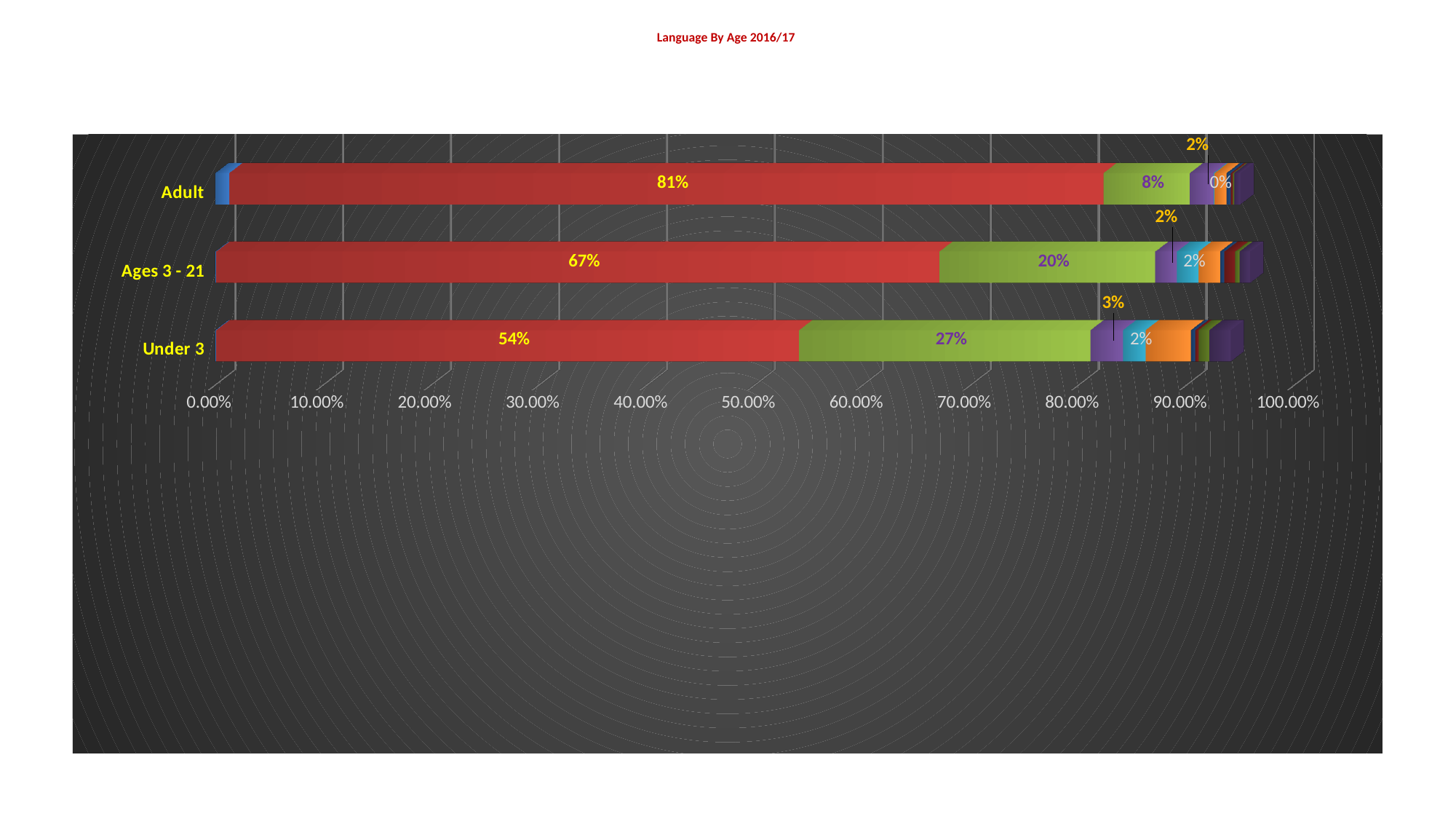
What is the value of the green segment for Adult? 8% What is the value of the red segment for Adult? 81% What is the title of the chart? Language By Age 2016/17 Which age category has the largest red segment? Adult What is the value of the green segment for Under 3? 27% Which age category has the smallest green segment? Adult What is the difference between the red segment values for Adult and Under 3? 27 percentage points How many age categories are shown on the chart? 3 What is the value of the red segment for Under 3? 54% What is the value of the red segment for Ages 3 - 21? 67% What type of chart is shown on the slide? Stacked bar chart Which is larger: the green segment for Ages 3 - 21 or the green segment for Under 3? Under 3